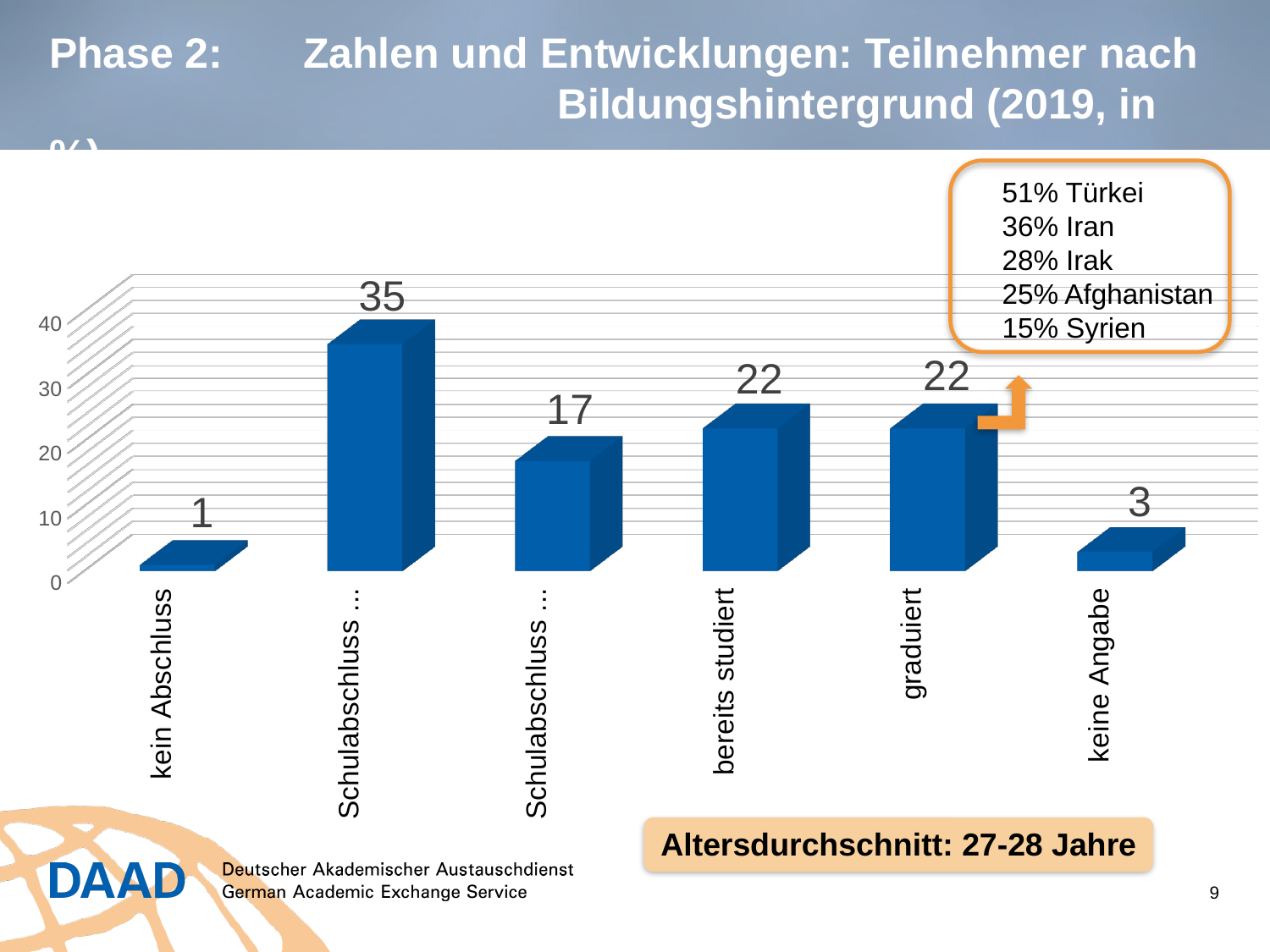
What is the value of the second bar from the left (the first 'Schulabschluss …' category)? 35 Which category has the lowest value? kein Abschluss What is the value for 'bereits studiert'? 22 What is the value for 'kein Abschluss'? 1 What is the value for 'keine Angabe'? 3 What is the difference between the second bar (35) and the third bar (17)? 18 What is the difference between the value for 'bereits studiert' and the value for 'keine Angabe'? 19 Which is larger, the value for 'keine Angabe' or the value for 'kein Abschluss'? keine Angabe What is the value for 'graduiert'? 22 How many categories are shown on the x axis? 6 What kind of chart is shown on the slide? bar chart Which category has the highest value? Schulabschluss … (second bar)